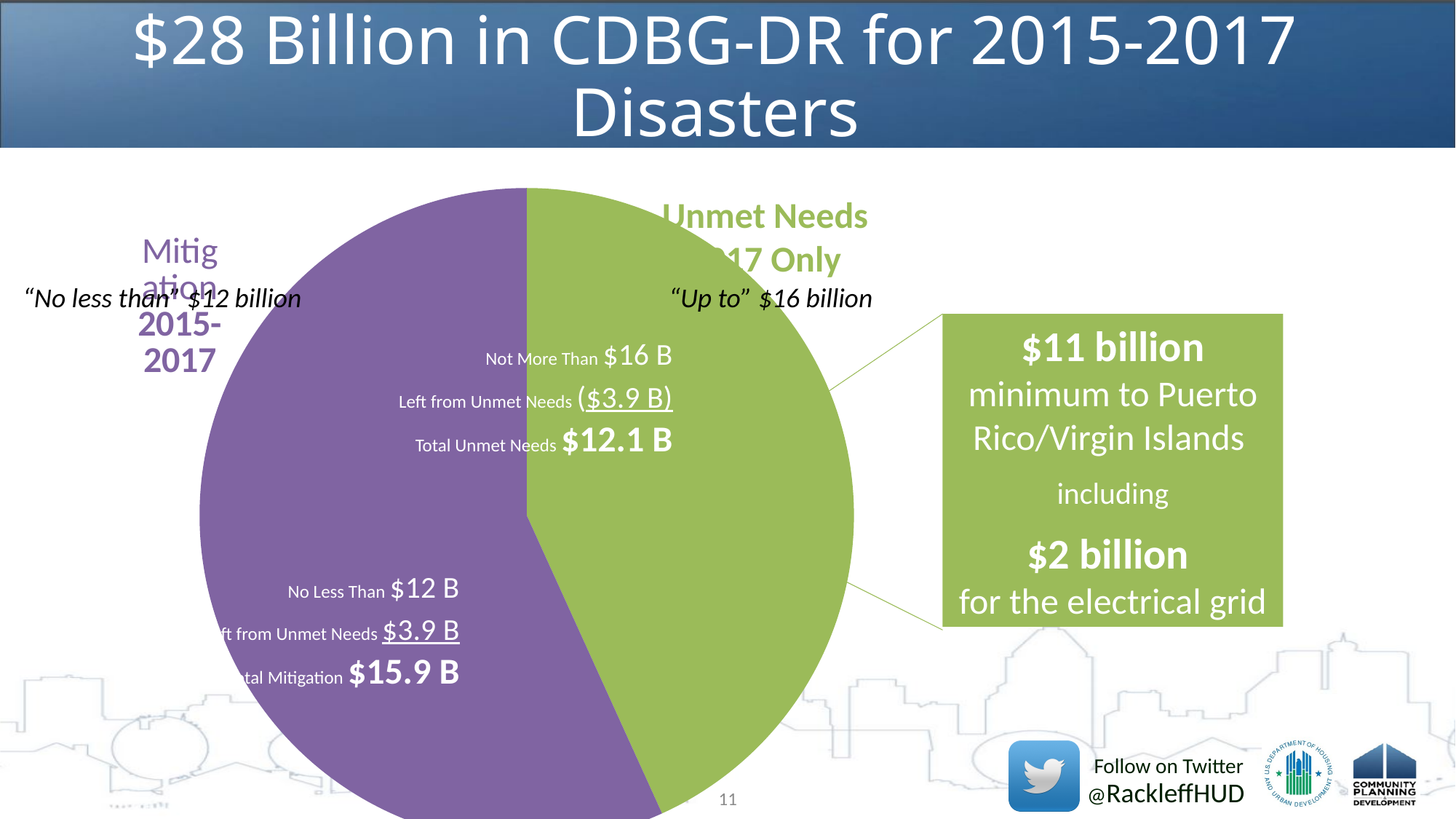
What is the Total Mitigation value shown on the purple slice? $15.9 B Which slice of the pie chart is the largest? Mitigation 2015-2017 What kind of chart is shown on the slide? pie chart What is the difference between Total Mitigation and Total Unmet Needs? $3.8 B How many slices does the pie chart have? 2 What is the 'No Less Than' amount listed for Mitigation? $12 B What amount is listed as 'Left from Unmet Needs'? $3.9 B What is the Total Unmet Needs value shown on the green slice? $12.1 B What is the 'Not More Than' amount listed for Unmet Needs? $16 B Which slice of the pie chart is the smallest? Unmet Needs 2017 Only What colour is the Mitigation 2015-2017 slice? purple Which is larger, Total Mitigation or Total Unmet Needs? Total Mitigation